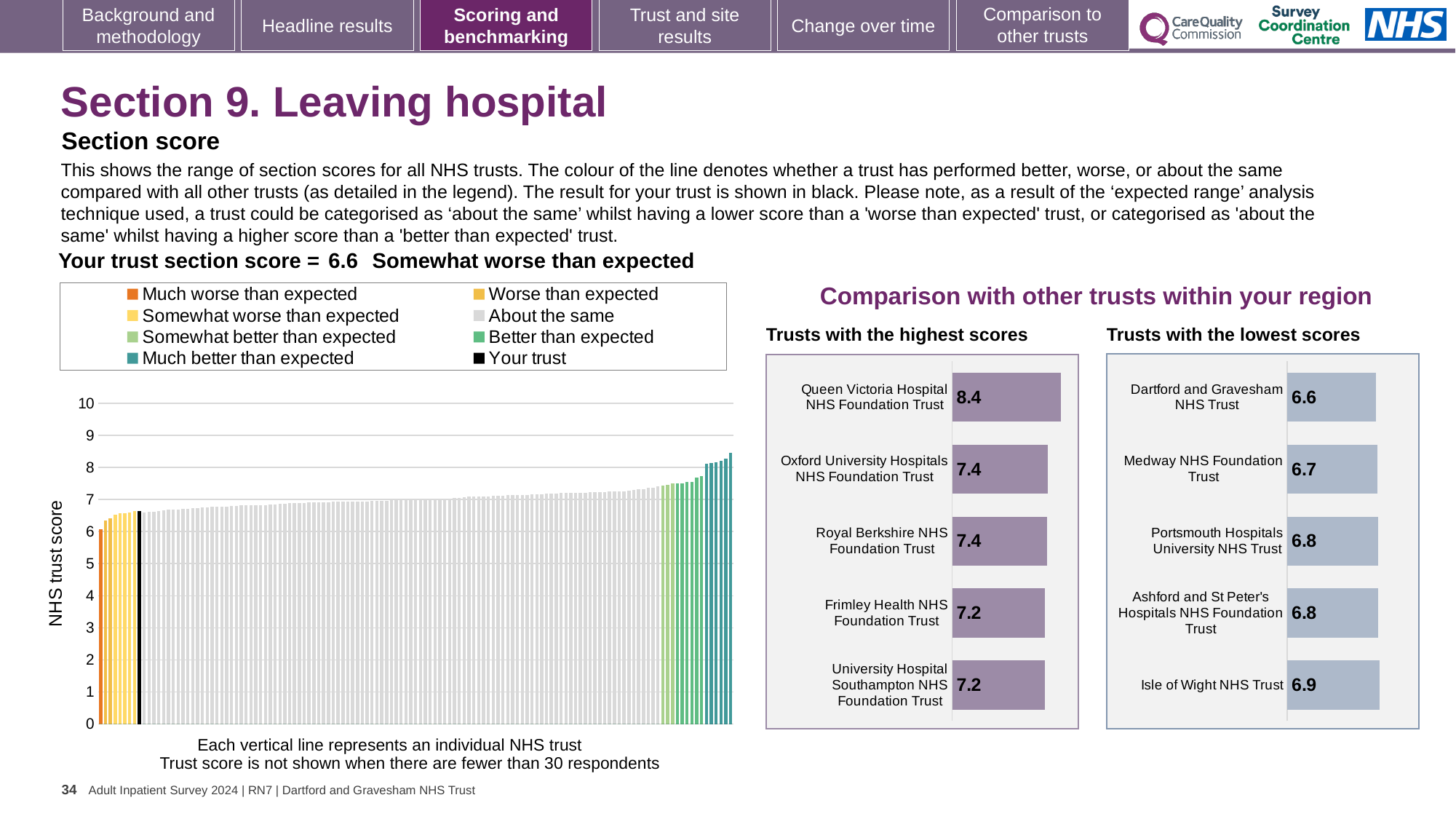
What kind of chart is the large chart on the left showing NHS trust scores? Bar chart In the 'Trusts with the lowest scores' chart, what is the score for Medway NHS Foundation Trust? 6.7 In the 'Trusts with the highest scores' chart, which trust has the highest score? Queen Victoria Hospital NHS Foundation Trust In the 'Trusts with the lowest scores' chart, what is the difference between the scores of Isle of Wight NHS Trust and Dartford and Gravesham NHS Trust? 0.3 How many entries does the legend of the large chart on the left list? 8 In the large chart on the left showing NHS trust scores, do the values rise or fall from left to right? Rise How many trusts are shown in the 'Trusts with the highest scores' chart? 5 What is the section score for your trust shown on the slide? 6.6 In the 'Trusts with the highest scores' chart, what is the score for Queen Victoria Hospital NHS Foundation Trust? 8.4 In the 'Trusts with the highest scores' chart, what is the difference between the scores of Queen Victoria Hospital NHS Foundation Trust and Frimley Health NHS Foundation Trust? 1.2 In the 'Trusts with the lowest scores' chart, which trust has the lowest score? Dartford and Gravesham NHS Trust In the 'Trusts with the lowest scores' chart, which has the higher score: Portsmouth Hospitals University NHS Trust or Isle of Wight NHS Trust? Isle of Wight NHS Trust